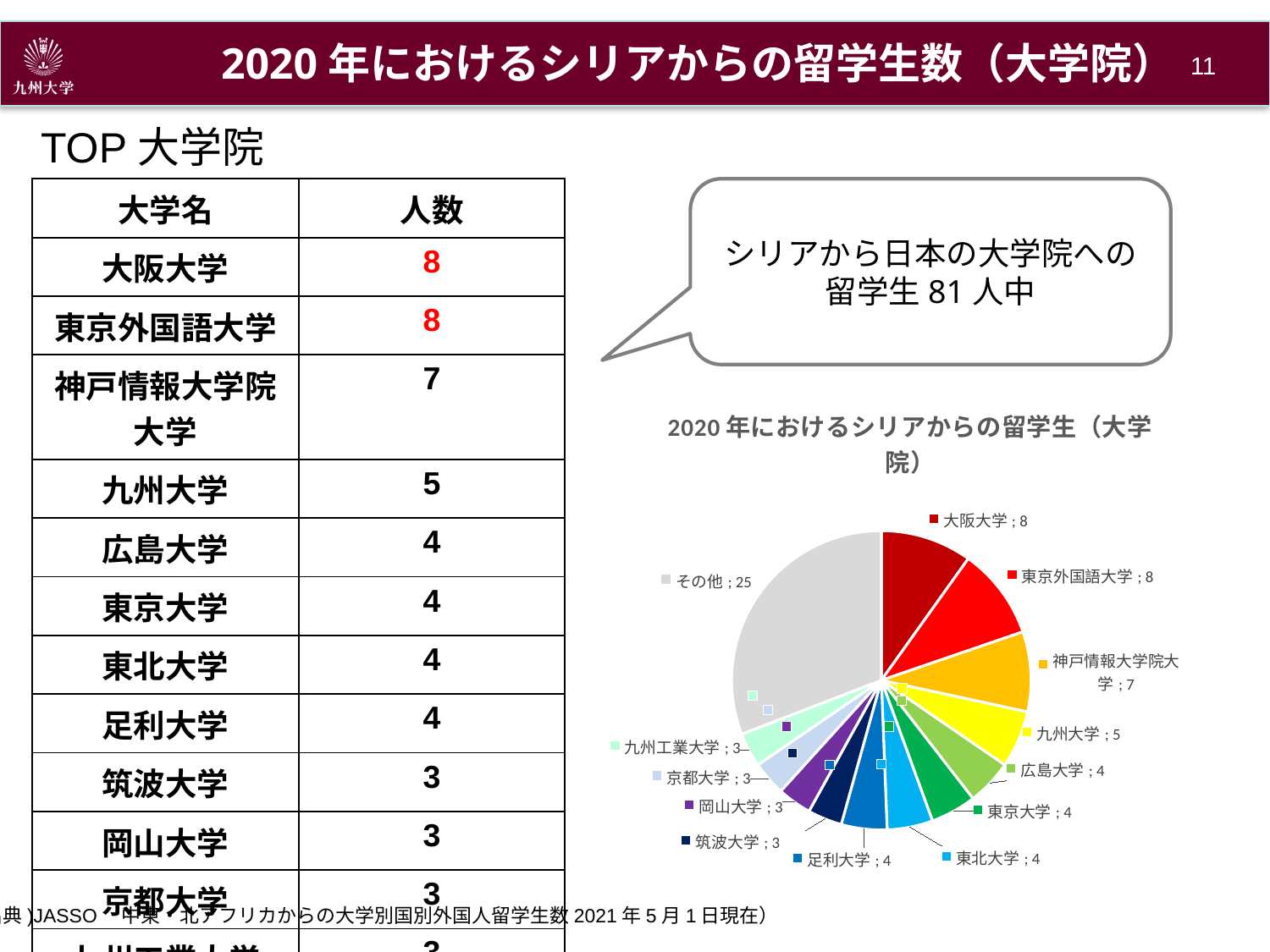
In the pie chart, how many students are shown for 大阪大学? 8 Which slice of the pie chart is the largest? その他 How many slices does the pie chart have? 13 Which named university (excluding その他) has the largest slice in the pie chart? 大阪大学 and 東京外国語大学 (8 each) What is the difference between the values for その他 and 大阪大学 in the pie chart? 17 In the pie chart, how many students are shown for 神戸情報大学院大学? 7 In the pie chart, how many students are shown for その他? 25 What is the title of the pie chart? 2020年におけるシリアからの留学生（大学院） In the pie chart, which is larger: the value for 九州大学 or the value for 広島大学? 九州大学 What kind of chart is shown on the slide? Pie chart What is the total number of students represented by the pie chart? 81 In the pie chart, how many students are shown for 九州大学? 5